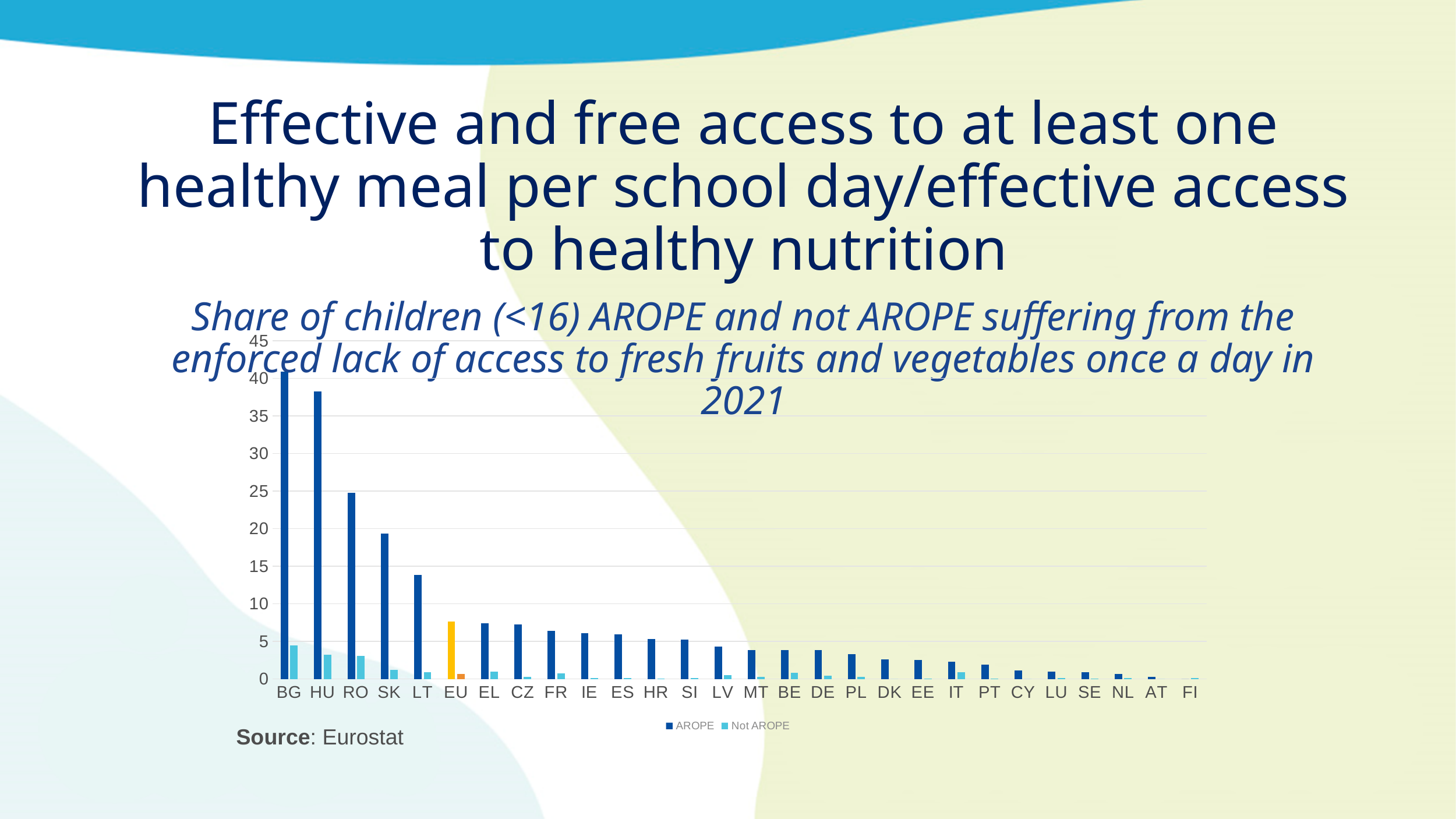
Do the AROPE values rise or fall moving from left to right along the x axis? fall Is the AROPE value for EU greater or less than 10? less How many series does the legend list? 2 Which category has the highest AROPE value? BG What kind of chart is shown on the slide? bar chart Is the AROPE value for LT greater or less than 10? greater How many categories are shown on the x axis? 28 Which category has the lowest AROPE value? FI Is the AROPE value for SK greater or less than 20? less Which has the larger AROPE value, HU or RO? HU What is the source cited below the chart? Eurostat